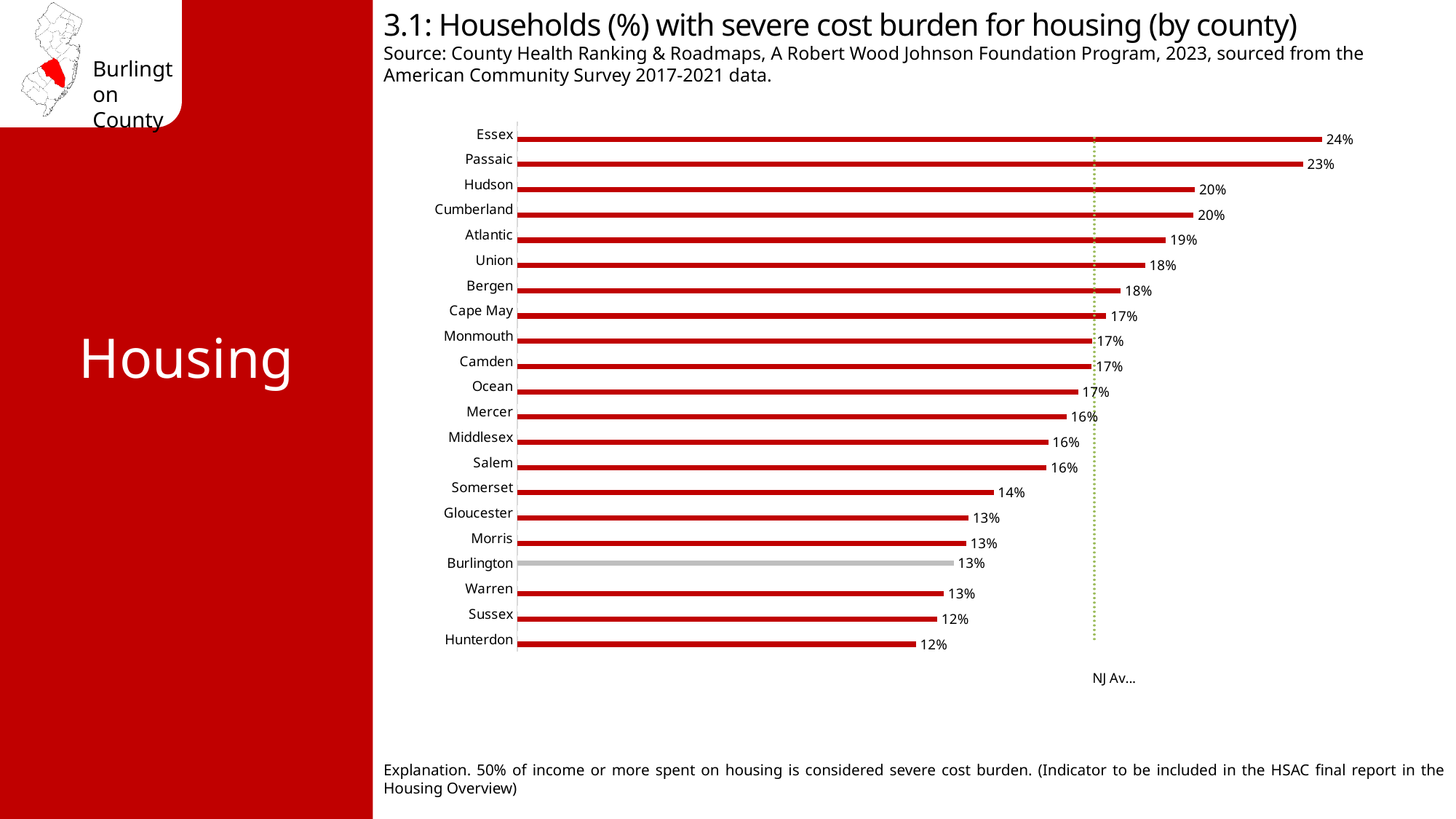
How many counties are shown on the chart? 21 What is the value shown for Atlantic County? 19% What kind of chart is shown on the slide? Bar chart What is the value shown for Burlington County? 13% Which has a higher value, Passaic or Hudson? Passaic What is the value shown for Somerset County? 14% What is the difference in percentage points between Essex and Burlington? 11 percentage points Which county has the highest percentage of households with severe housing cost burden? Essex What does the vertical dotted line on the chart represent? NJ Average What percentage of households in Essex County have a severe housing cost burden? 24% What is the lowest percentage value shown on the chart? 12% Which county's bar is shown in grey rather than red? Burlington